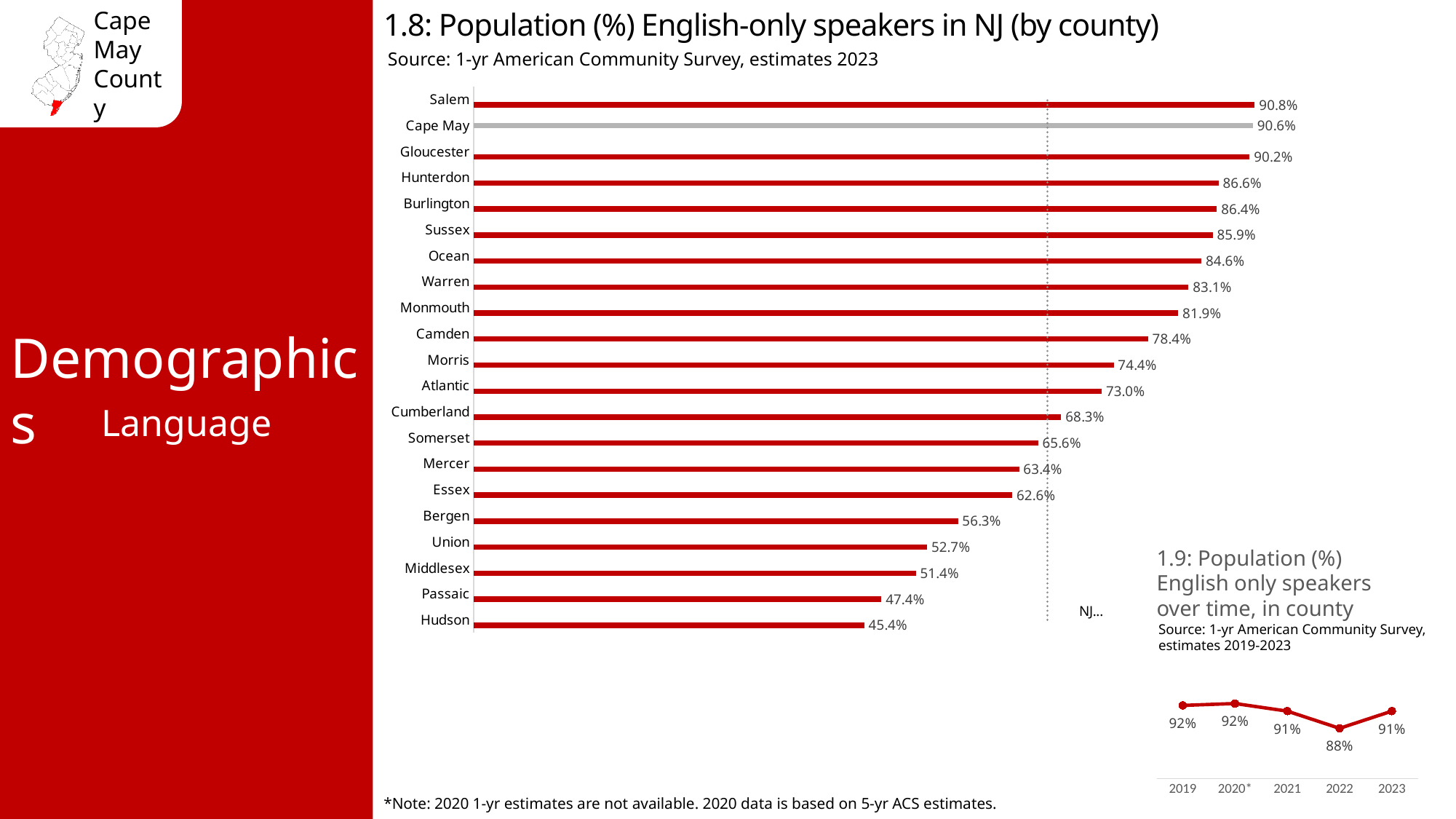
In chart 1.8, which county has the highest percentage of English-only speakers? Salem In chart 1.8, what is the value for Hudson? 45.4% In chart 1.8, which has a higher value, Bergen or Essex? Essex In chart 1.9, what is the value for 2022? 88% In chart 1.8, what percentage of Cape May's population are English-only speakers? 90.6% In chart 1.8, how many counties are shown? 21 In chart 1.8, which county has the lowest percentage of English-only speakers? Hudson What type of chart is chart 1.8? Bar chart In chart 1.8, which county's bar is coloured grey instead of red? Cape May In chart 1.9, how many years are plotted? 5 In chart 1.8, what is the difference between Salem and Cape May? 0.2% In chart 1.9, which year has the lowest value? 2022